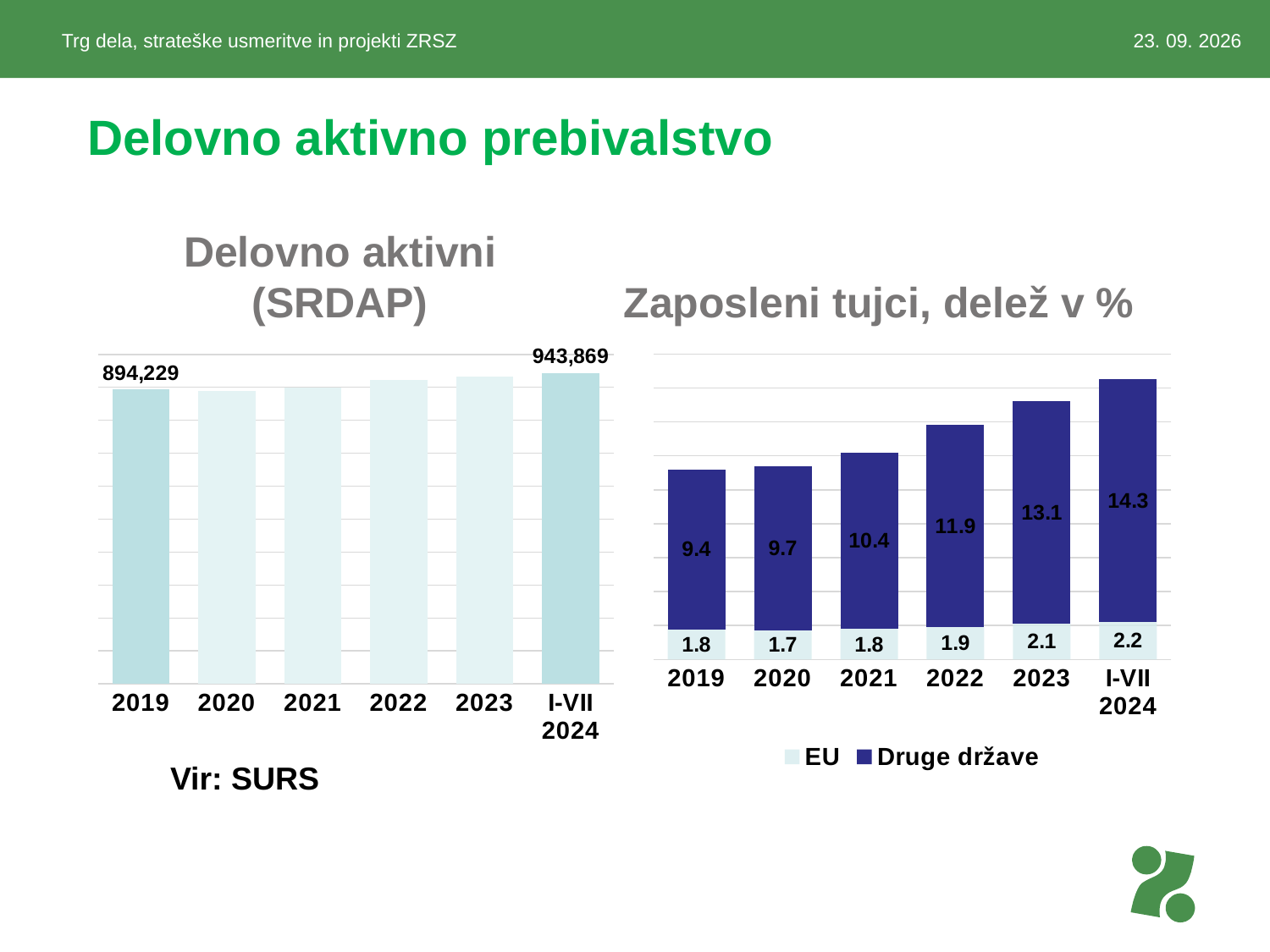
On the left chart (Delovno aktivni (SRDAP)), how many periods are shown on the x axis? 6 On the right chart (Zaposleni tujci, delež v %), what is the Druge države value for 2022? 11.9 On the right chart (Zaposleni tujci, delež v %), what is the EU value for 2023? 2.1 On the right chart (Zaposleni tujci, delež v %), what is the total of the stacked bar for I-VII 2024? 16.5 What kind of chart is the left chart (Delovno aktivni (SRDAP))? Bar chart On the right chart (Zaposleni tujci, delež v %), how many series does the legend list? 2 On the right chart (Zaposleni tujci, delež v %), do the Druge države values rise or fall from 2019 to I-VII 2024? Rise On the left chart (Delovno aktivni (SRDAP)), what is the value for I-VII 2024? 943,869 On the right chart (Zaposleni tujci, delež v %), which period has the highest Druge države value? I-VII 2024 On the right chart (Zaposleni tujci, delež v %), which period has the lowest EU value? 2020 On the left chart (Delovno aktivni (SRDAP)), what is the value for 2019? 894,229 On the left chart (Delovno aktivni (SRDAP)), what is the difference between the I-VII 2024 value and the 2019 value? 49,640